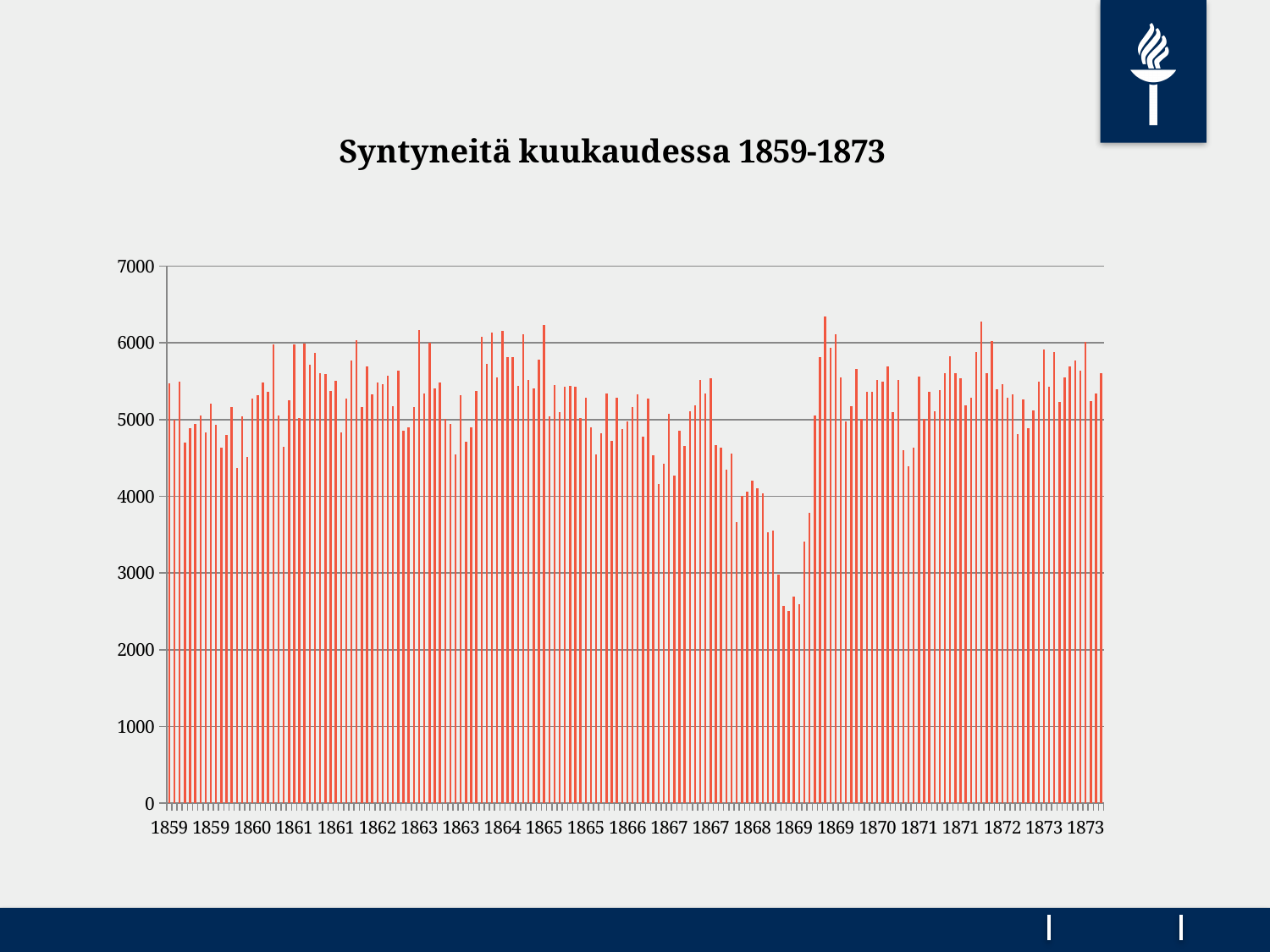
Is the tallest bar in the chart greater or less than 7000? less Do the values fall sharply and then recover around 1868-1869? yes Are the lowest bars in the chart, in the dip around 1868-1869, greater or less than 3000? less Are the majority of the bars in the chart above or below 4000? above Does the chart display a legend? No What kind of chart is shown on the slide? bar chart What is the title of the chart? Syntyneitä kuukaudessa 1859-1873 Around which years do the values drop sharply to their lowest level? 1868-1869